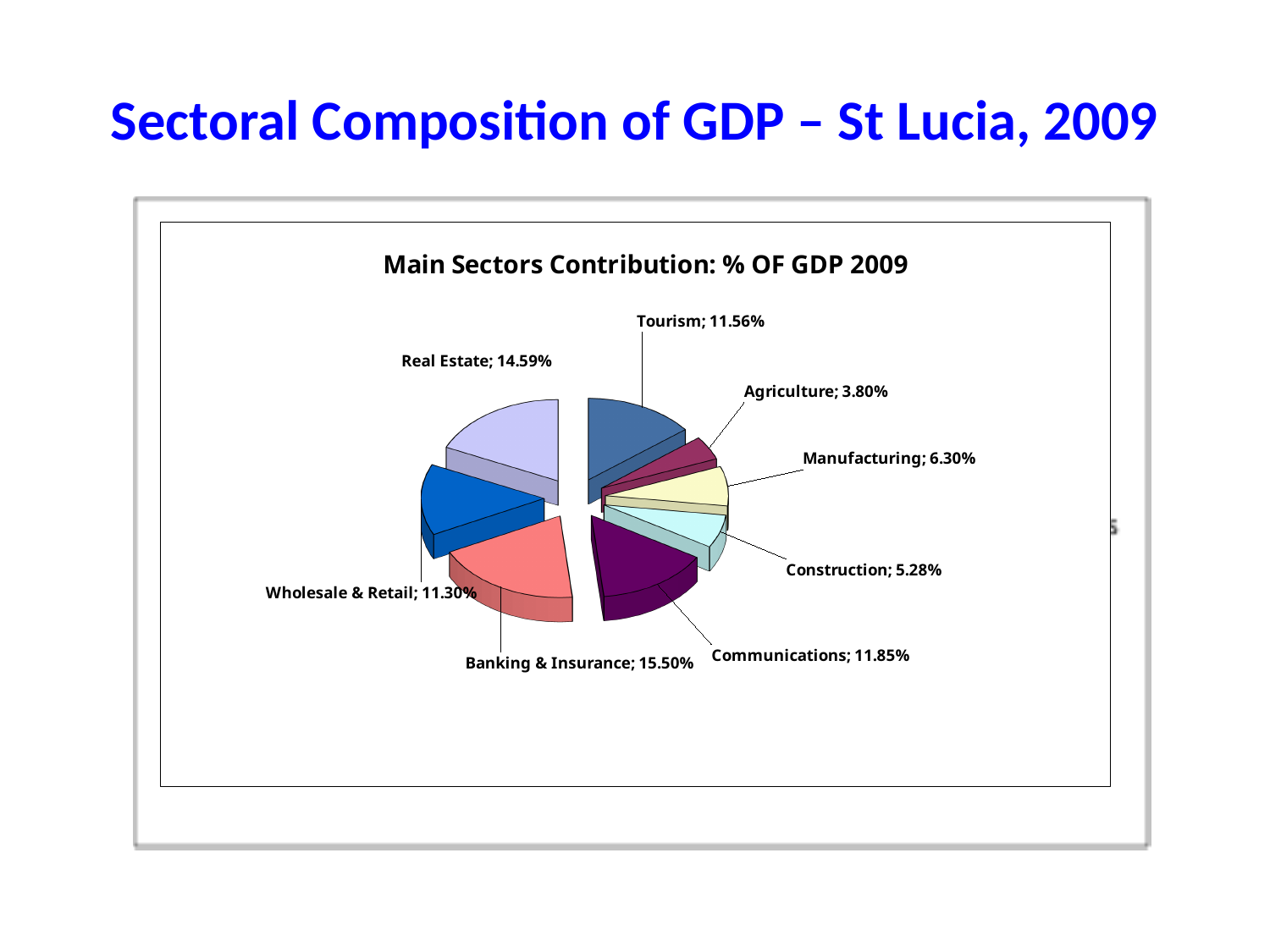
What percentage of GDP does Tourism contribute? 11.56% What is the difference between the Manufacturing and Construction shares? 1.02% Which is larger, the share for Communications or the share for Manufacturing? Communications What is the value shown for Agriculture? 3.80% How many sectors are shown in the pie chart? 8 What kind of chart is shown on the slide? Pie chart What is the difference between the Real Estate and Wholesale & Retail shares? 3.29% Which sector has the smallest share of GDP? Agriculture What is the title of the chart? Main Sectors Contribution: % OF GDP 2009 Which sector has the largest share of GDP? Banking & Insurance What is the value shown for Banking & Insurance? 15.50% What is the value shown for Construction? 5.28%